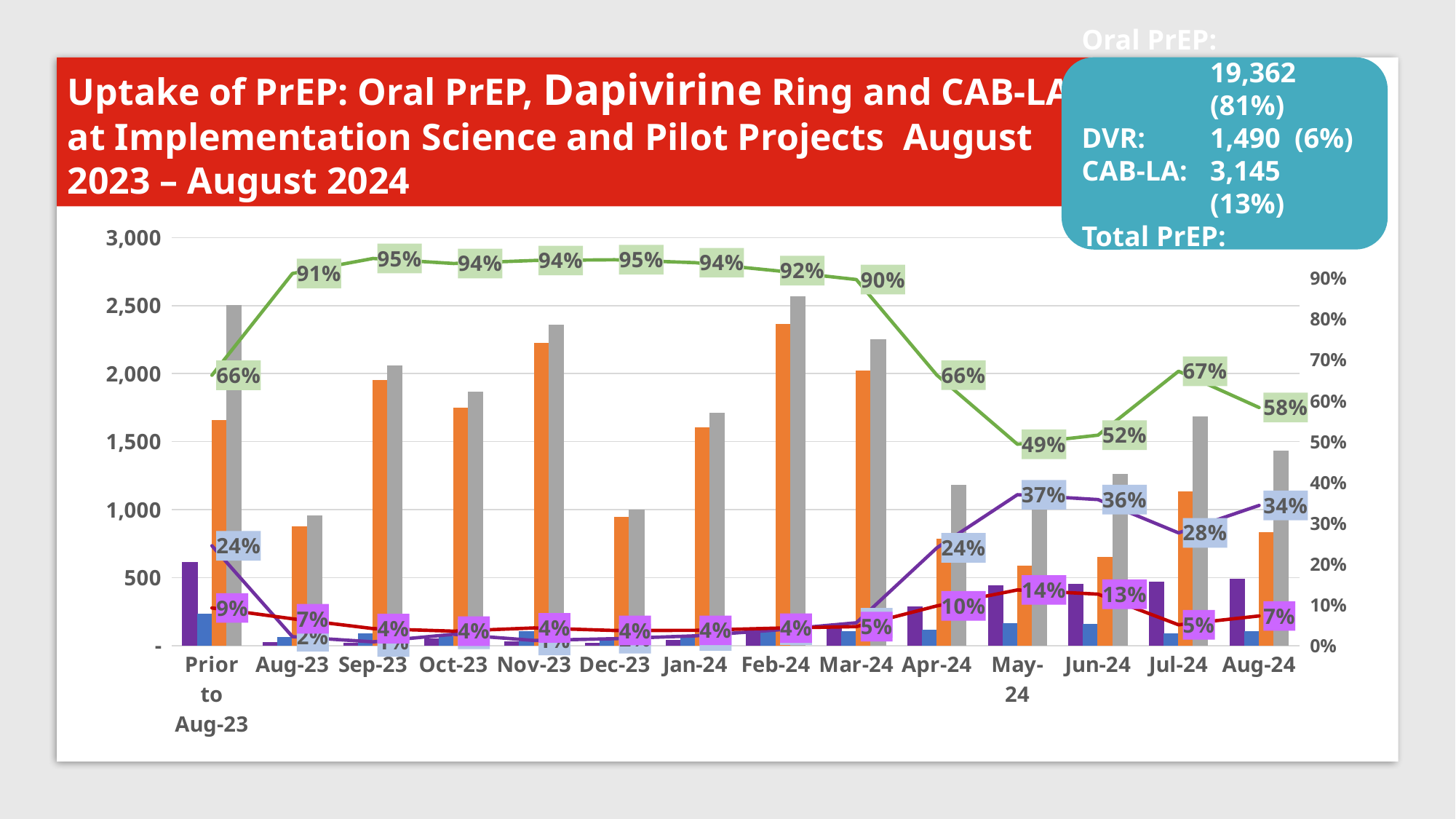
Is the orange bar for Nov-23 greater or less than 2,000? greater What value does the purple line show for Aug-24? 34% At which month does the red line reach its highest value? May-24 Does the green line rise or fall from Mar-24 to May-24? Fall By how many percentage points does the green line drop from Mar-24 to Apr-24? 24 percentage points What value does the green line show for Sep-23? 95% At which month does the green line reach its lowest value? May-24 How many time periods are shown on the x axis? 14 Which is larger on the purple line: the value for Apr-24 or the value for Jul-24? Jul-24 What value does the red line show for May-24? 14% What kind of chart is shown on the slide? Combination bar and line chart What value does the green line show for May-24? 49%